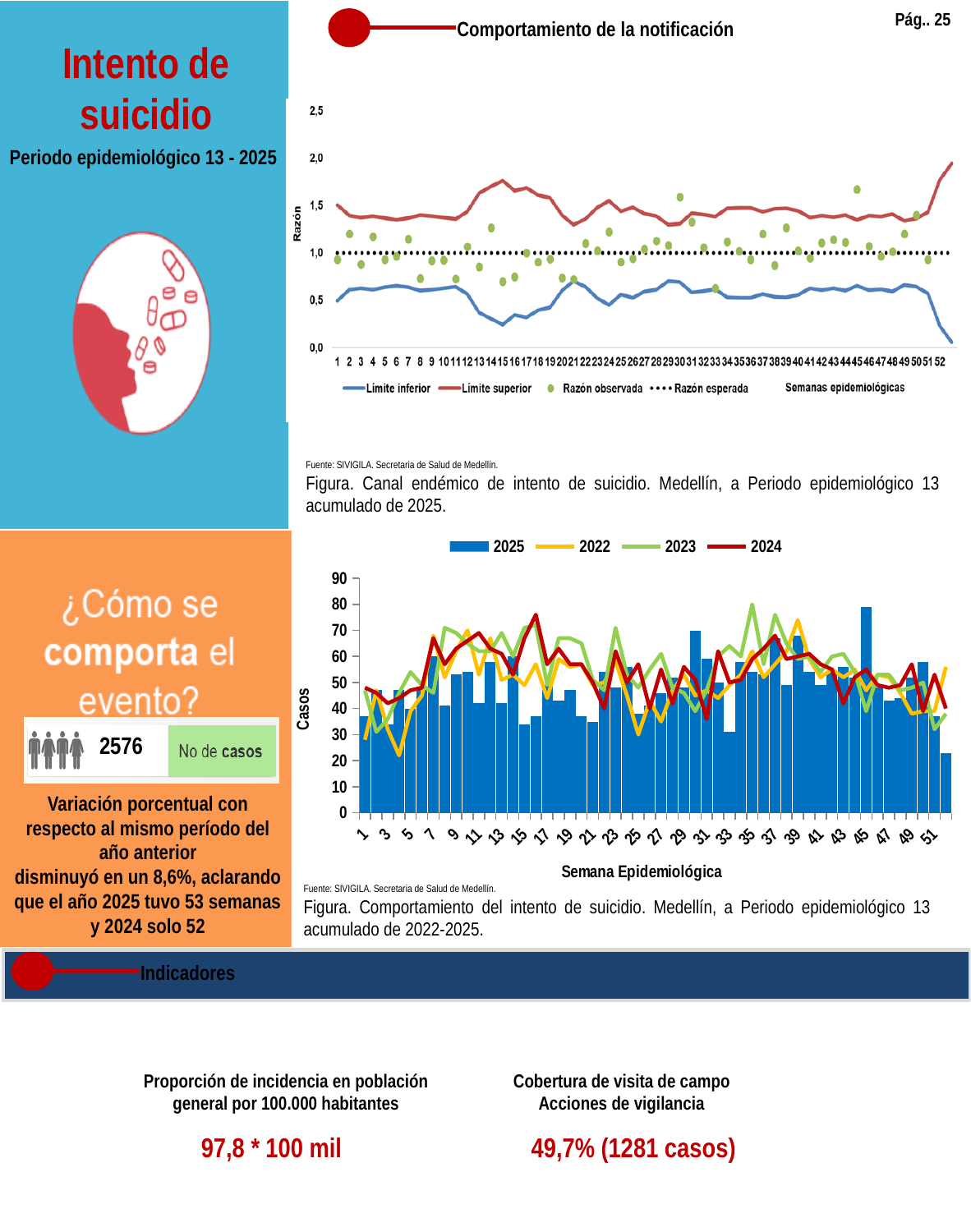
How many epidemiological weeks are shown on the x axis of the top chart (Canal endémico de intento de suicidio)? 52 In the bottom chart (Comportamiento del intento de suicidio), what kind of chart is used to show the 2025 series? Bar chart How many series does the legend of the bottom chart (Comportamiento del intento de suicidio) list? 4 In the top chart (Canal endémico de intento de suicidio), is the Límite superior value at week 52 greater or less than 1,5? greater In the top chart (Canal endémico de intento de suicidio), what value does the Razón esperada dotted line sit at? 1,0 In the top chart (Canal endémico de intento de suicidio), is the Límite inferior value at week 52 greater or less than 0,5? less In the bottom chart (Comportamiento del intento de suicidio), is the 2025 value for week 45 greater or less than 70? greater How many series does the legend of the top chart (Canal endémico de intento de suicidio) list? 4 Which years are listed in the legend of the bottom chart (Comportamiento del intento de suicidio)? 2025, 2022, 2023, 2024 In the bottom chart (Comportamiento del intento de suicidio), which series is drawn as bars rather than a line? 2025 What is the label of the y axis in the bottom chart (Comportamiento del intento de suicidio)? Casos